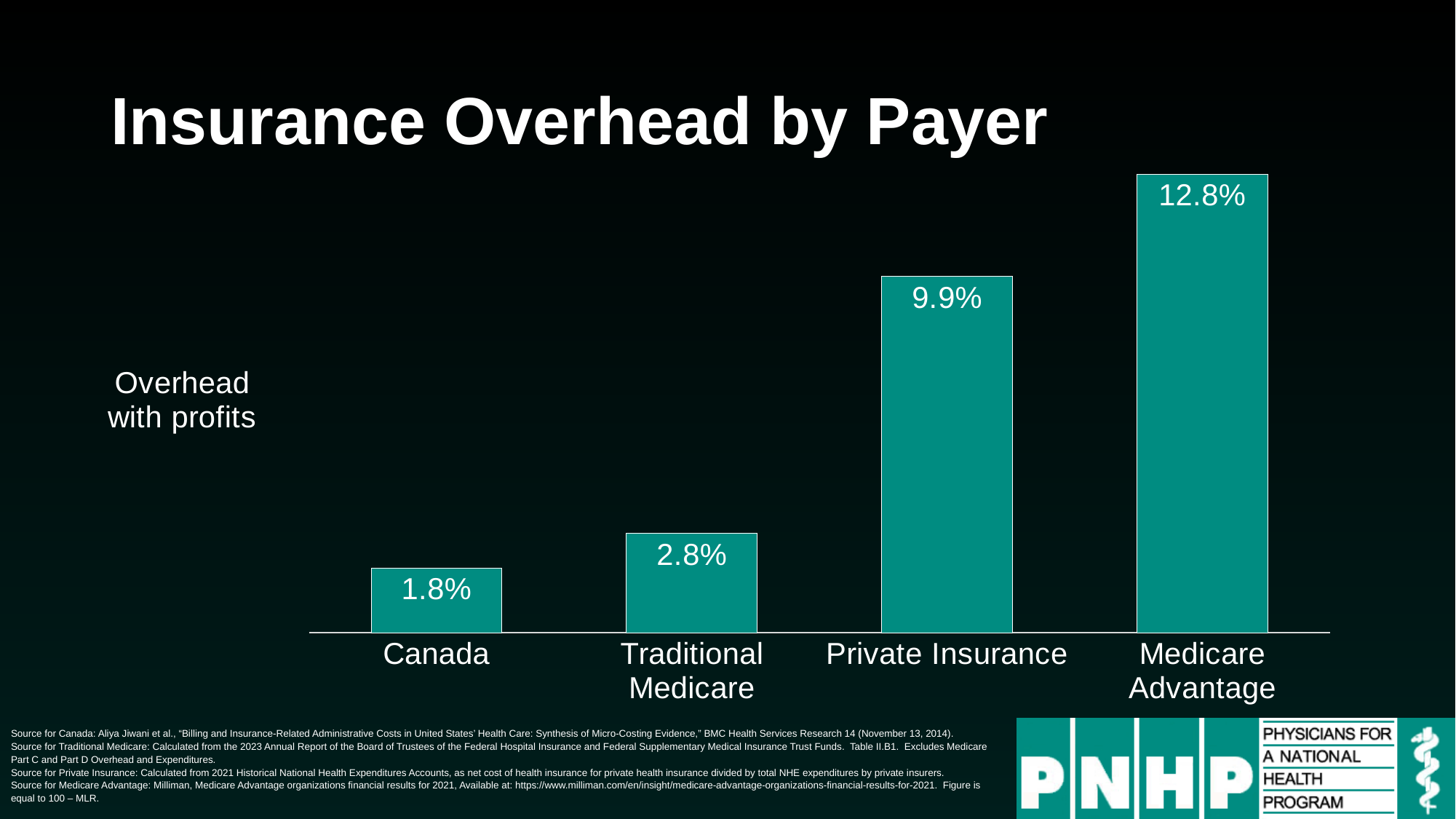
Which payer has the lowest overhead with profits? Canada What is the overhead with profits value for Traditional Medicare? 2.8% How many payers are shown in the chart? 4 Which payer has the highest overhead with profits? Medicare Advantage What is the title of the chart on the slide? Insurance Overhead by Payer What is the difference in overhead between Medicare Advantage and Private Insurance? 2.9% What is the difference in overhead between Traditional Medicare and Canada? 1.0% What kind of chart is shown on the slide? Bar chart What is the overhead with profits value for Canada? 1.8% What is the overhead with profits value for Private Insurance? 9.9% What is the overhead with profits value for Medicare Advantage? 12.8% Which has higher overhead, Private Insurance or Traditional Medicare? Private Insurance